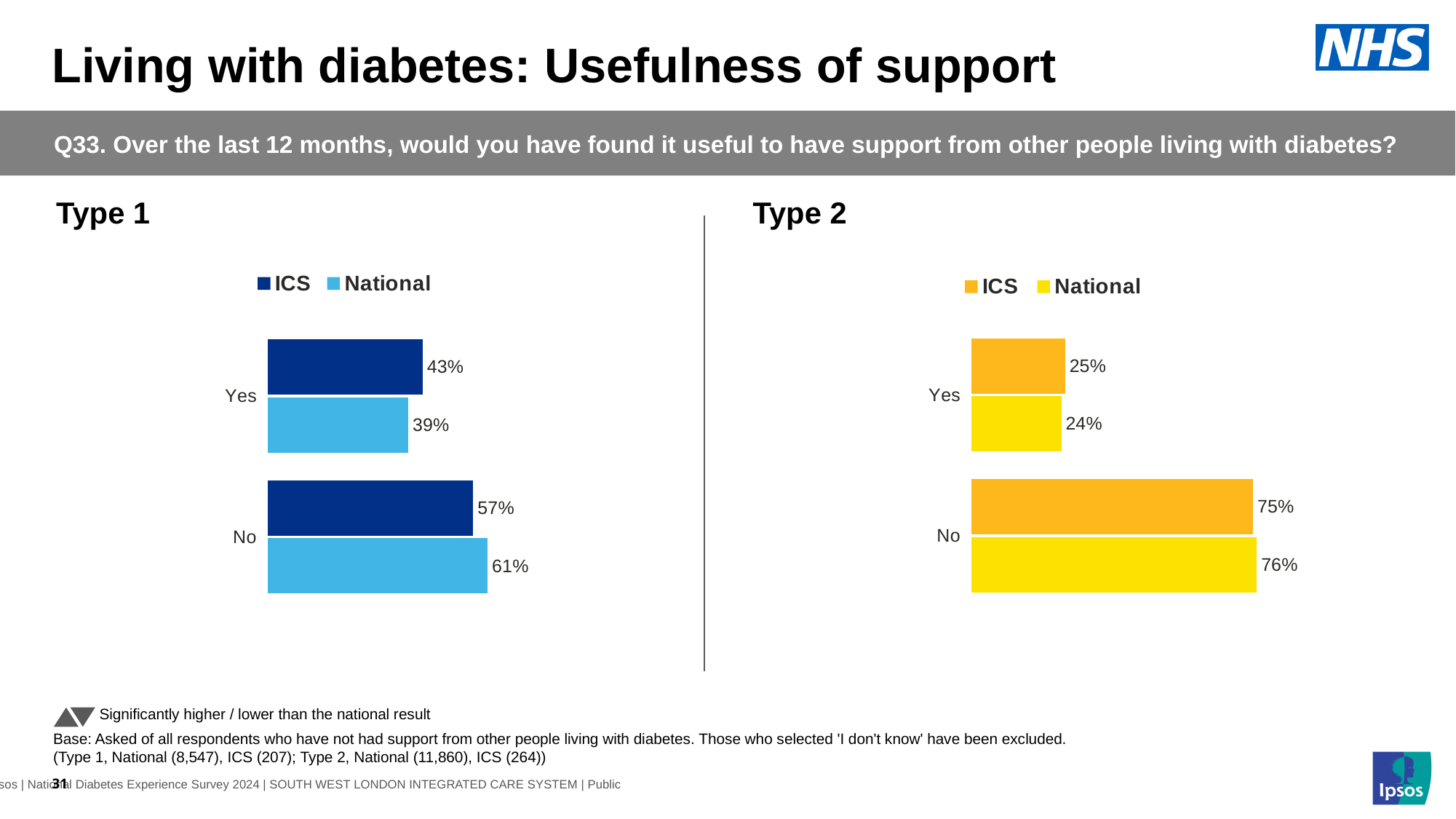
What kind of chart is the Type 1 chart? Bar chart In the Type 2 chart, which series has the highest value overall? National (76%) In the Type 2 chart, what is the ICS value for No? 75% In the Type 1 chart, which is larger for No: ICS or National? National In the Type 2 chart, what is the difference between the National and ICS values for No? 1 percentage point In the Type 1 chart, what is the ICS value for Yes? 43% In the Type 1 chart, what is the difference between the ICS and National values for Yes? 4 percentage points In the Type 1 chart, what is the National value for No? 61% How many categories are shown in the Type 2 chart? 2 In the Type 2 chart, which bar has the lowest value? National, Yes (24%) In the Type 2 chart, what is the National value for Yes? 24% How many series does the legend of the Type 1 chart list? 2